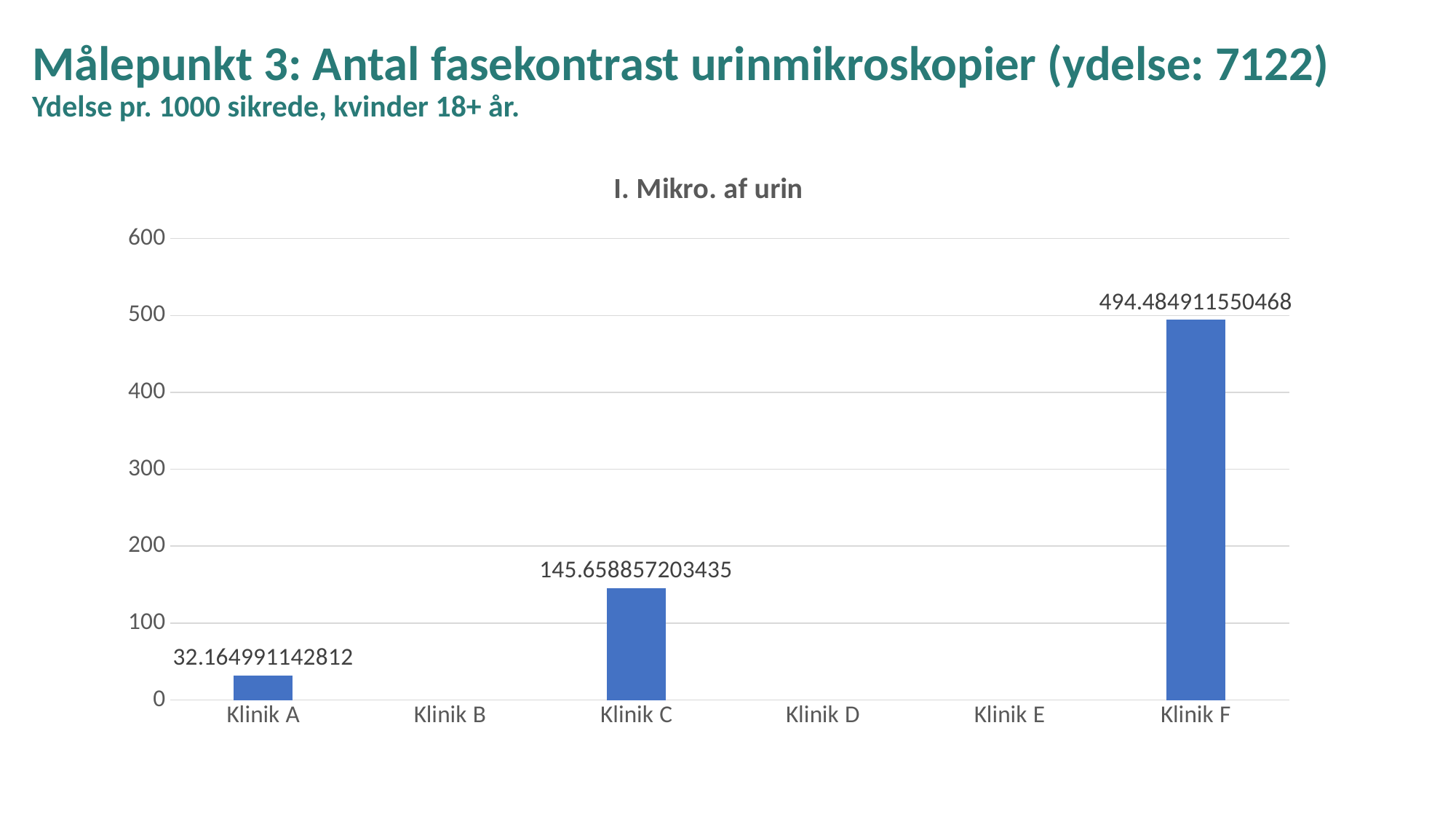
What is the value for Klinik C? 145.658857203435 What is the title of the chart? I. Mikro. af urin How many clinics are shown on the x axis? 6 What is the value for Klinik A? 32.164991142812 Is the value for Klinik A greater or less than 100? less What is the value for Klinik F? 494.484911550468 What is the difference between the values for Klinik C and Klinik A? 113.493866060623 What kind of chart is shown on the slide? bar chart Which is larger, the value for Klinik A or the value for Klinik C? Klinik C What is the difference between the values for Klinik F and Klinik C? 348.826054347033 Which clinic has the highest value? Klinik F Is the value for Klinik F greater or less than 400? greater